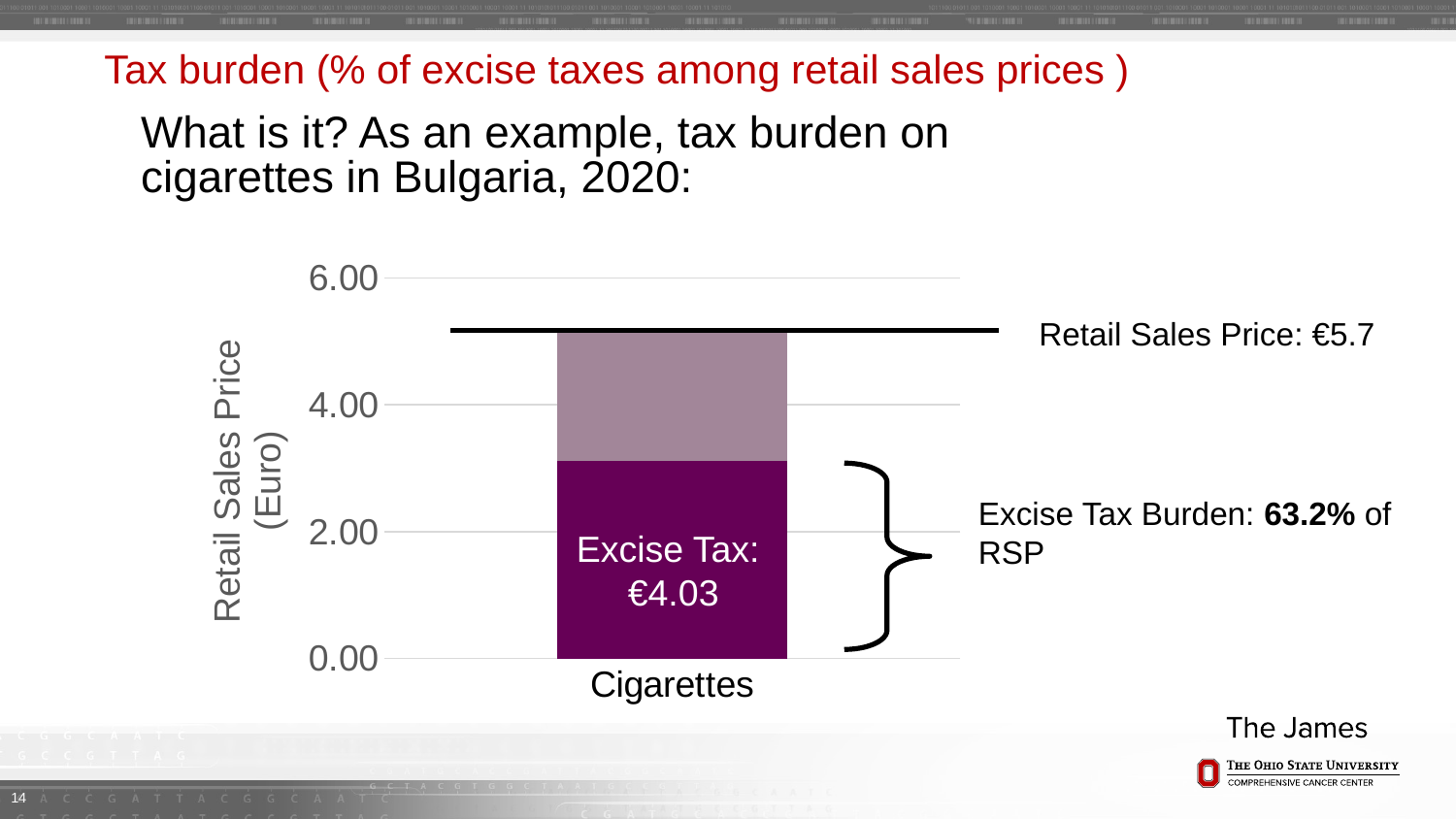
What kind of chart is shown on the slide? Bar chart Which portion of the cigarettes bar is larger: the excise tax portion or the remaining non-excise portion? Excise tax portion Is the excise tax value for cigarettes greater or less than 2.00? greater What is the excise tax burden as a percentage of the retail sales price? 63.2% What is the excise tax value shown on the bar for cigarettes? €4.03 What is the label of the y axis of the chart? Retail Sales Price (Euro) What is the category label on the x axis of the chart? Cigarettes What is the difference between the retail sales price (€5.7) and the excise tax (€4.03)? €1.67 Is the retail sales price for cigarettes greater or less than 6.00? less What is the retail sales price of cigarettes shown on the chart? €5.7 How many categories are plotted on the x axis of the chart? 1